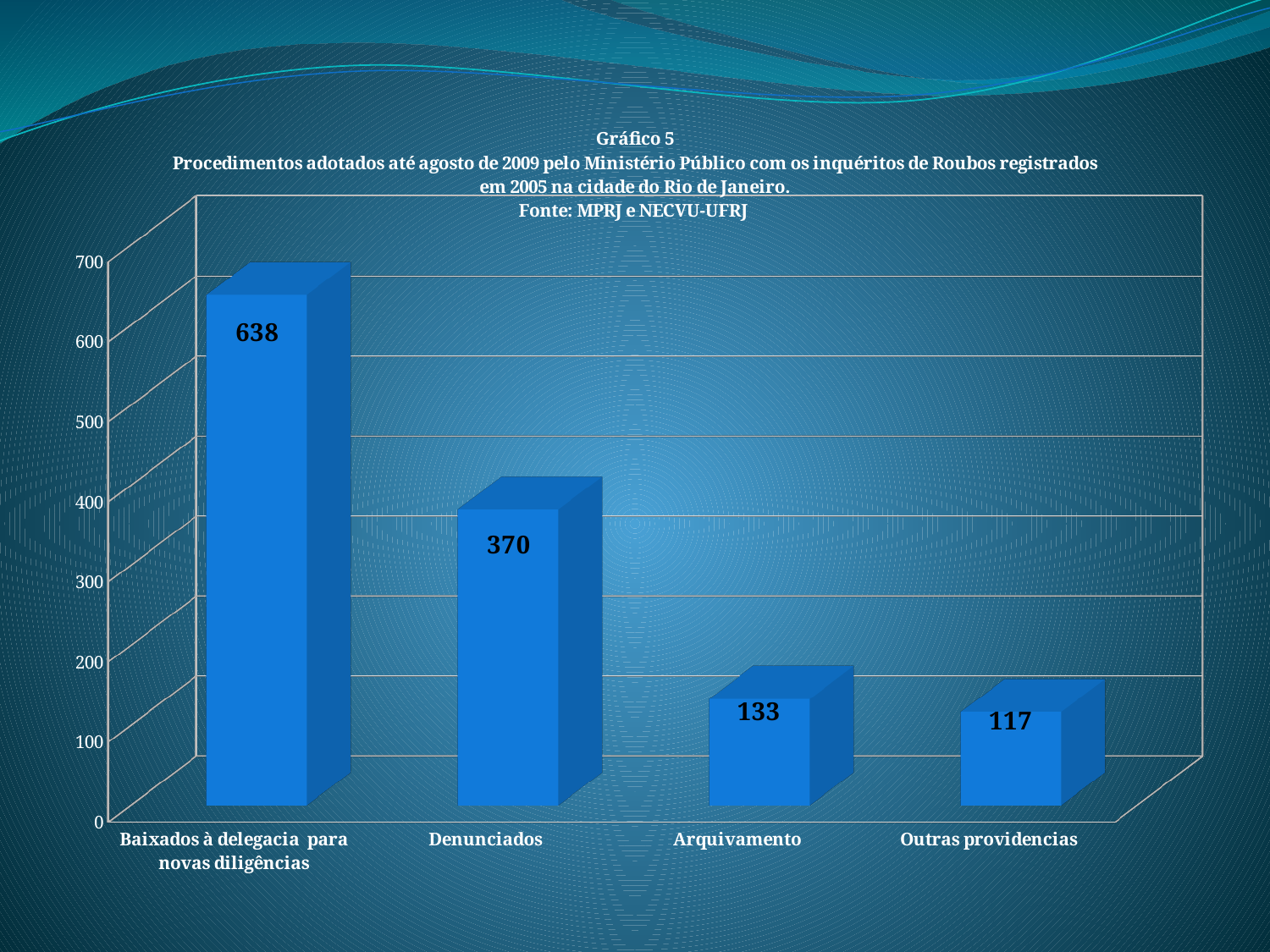
What source is cited in the chart title? MPRJ e NECVU-UFRJ What is the difference between the values for Arquivamento and Outras providencias? 16 What is the value for Outras providencias? 117 Which is larger, the value for Denunciados or the value for Arquivamento? Denunciados What is the value for Arquivamento? 133 What is the value for Baixados à delegacia para novas diligências? 638 What is the value for Denunciados? 370 What kind of chart is shown on the slide? Bar chart What is the difference between the values for Baixados à delegacia para novas diligências and Denunciados? 268 Which category has the highest value? Baixados à delegacia para novas diligências Which category has the lowest value? Outras providencias How many categories are shown on the x axis? 4